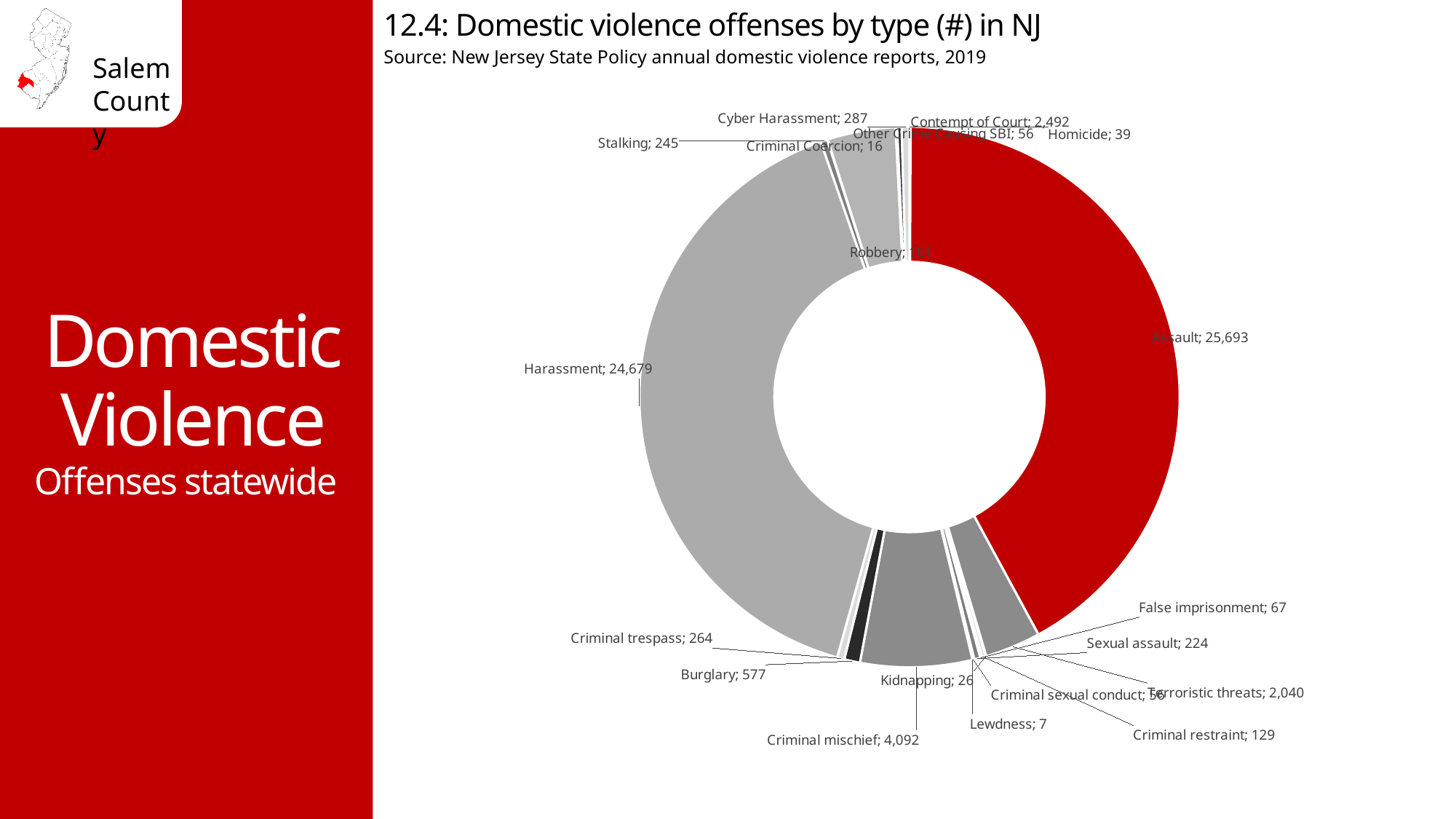
What is the value for Criminal mischief? 4,092 What is the value for Harassment? 24,679 What is the value for Terroristic threats? 2,040 Which offense type has the lowest number of offenses? Lewdness What is the value for Homicide? 39 What kind of chart is shown on the slide? doughnut chart What is the value for Burglary? 577 How many domestic violence offenses of type Assault are shown? 25,693 Which offense type has the highest number of offenses? Assault What is the title of the chart? 12.4: Domestic violence offenses by type (#) in NJ What is the difference between the Assault and Harassment values? 1,014 Which is larger, Cyber Harassment or Criminal trespass? Cyber Harassment